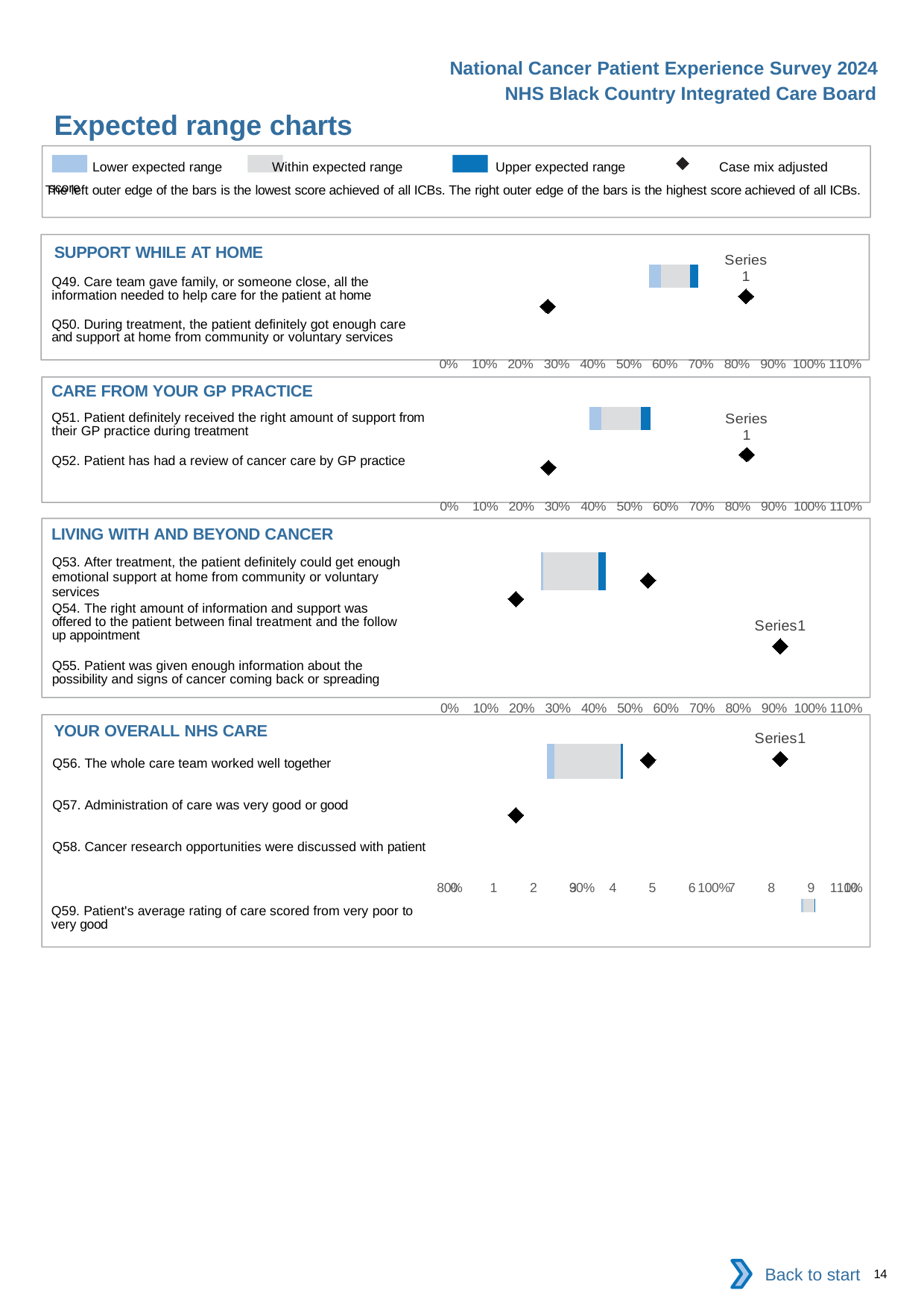
What is the title of the slide's charts section? Expected range charts In the SUPPORT WHILE AT HOME chart, is the leftmost diamond marker greater or less than 50%? less How many questions are listed in the CARE FROM YOUR GP PRACTICE chart? 2 In the CARE FROM YOUR GP PRACTICE chart, is the leftmost diamond marker greater or less than 50%? less How many entries does the legend at the top of the slide list? 4 In the YOUR OVERALL NHS CARE chart, is the diamond marker to the right of the shaded bar greater or less than 50%? greater What is the highest tick label shown on the x axis of the SUPPORT WHILE AT HOME chart? 110% What kind of chart is used in the SUPPORT WHILE AT HOME section? Bar chart How many questions are listed in the YOUR OVERALL NHS CARE chart? 4 How many questions are listed in the LIVING WITH AND BEYOND CANCER chart? 3 In the legend, which colour represents the upper expected range? Dark blue